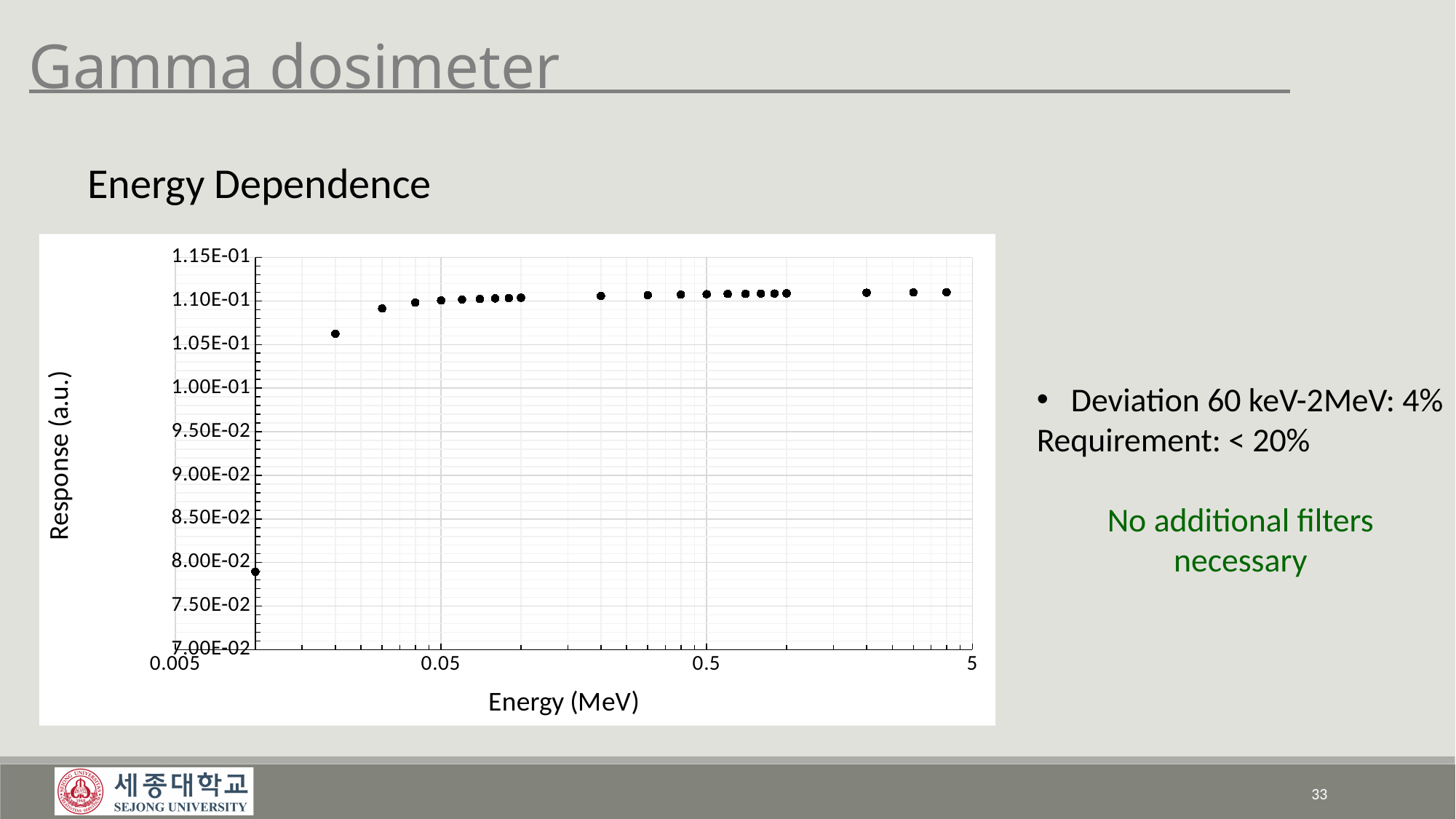
What is the title of the chart's y axis? Response (a.u.) What is the title of the chart's x axis? Energy (MeV) Does the response rise or fall as energy increases from 0.005 MeV to 0.05 MeV? rise At which energy is the plotted response lowest? 0.005 MeV Which has the larger response: the point at 0.005 MeV or the point at 0.5 MeV? 0.5 MeV What is the highest value shown on the y axis? 1.15E-01 What kind of chart is shown on the slide? scatter plot Is the response at 0.005 MeV greater or less than 9.00E-02? less Is the response at 0.5 MeV greater or less than 1.00E-01? greater